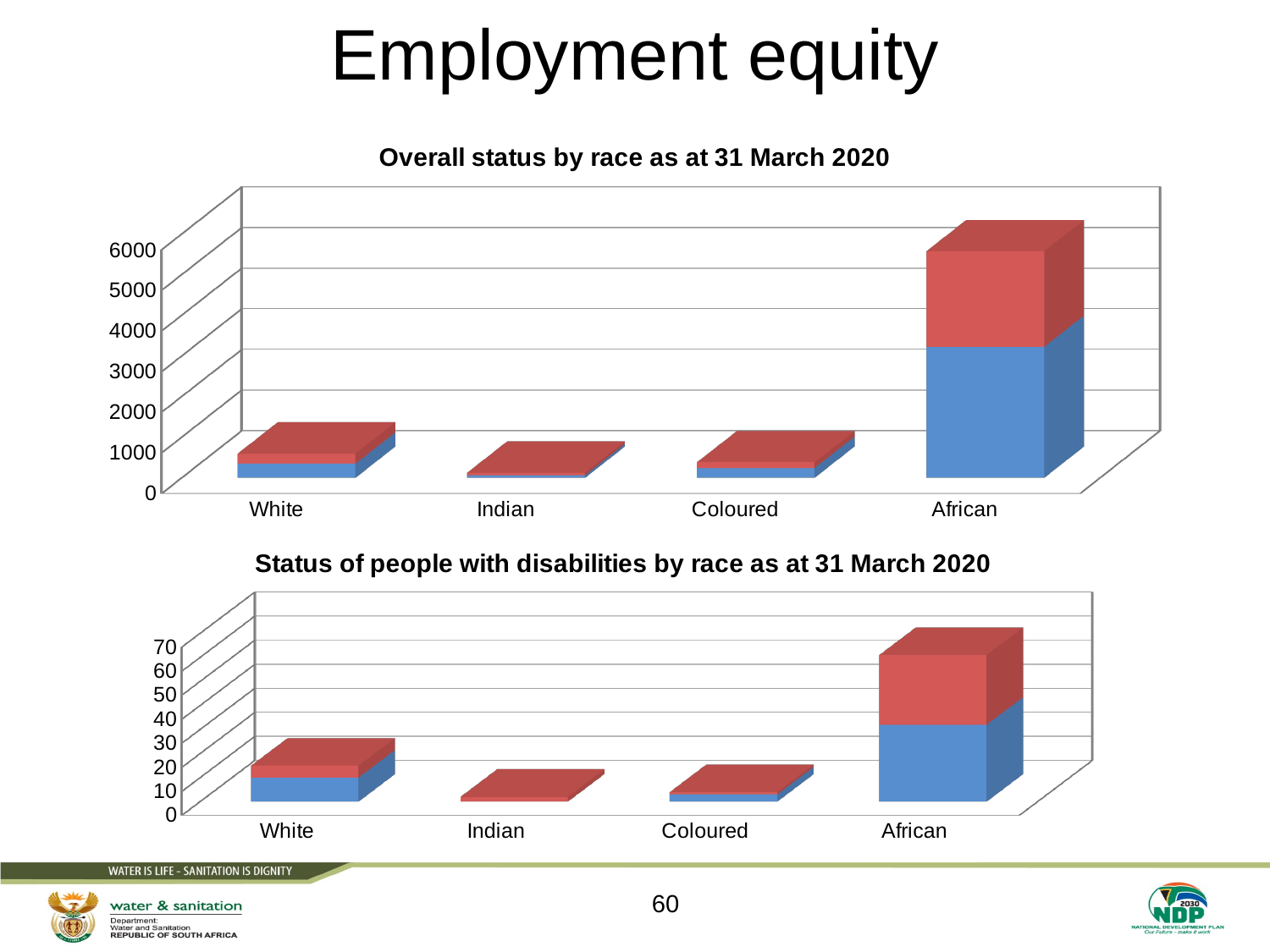
In the 'Status of people with disabilities by race as at 31 March 2020' chart, which race has the lowest bar? Indian In the 'Status of people with disabilities by race as at 31 March 2020' chart, is the total value for African greater or less than 40? greater In the 'Overall status by race as at 31 March 2020' chart, which race has the highest bar? African In the 'Overall status by race as at 31 March 2020' chart, is the total value for Indian greater or less than 1000? less What kind of chart is the 'Status of people with disabilities by race as at 31 March 2020' chart? Bar chart In the 'Overall status by race as at 31 March 2020' chart, which is larger, the bar for African or the bar for White? African In the 'Status of people with disabilities by race as at 31 March 2020' chart, which is larger, the bar for White or the bar for Coloured? White In the 'Overall status by race as at 31 March 2020' chart, which race has the lowest bar? Indian In the 'Status of people with disabilities by race as at 31 March 2020' chart, which race has the highest bar? African How many race categories are shown on the x axis of the 'Overall status by race as at 31 March 2020' chart? 4 In the 'Overall status by race as at 31 March 2020' chart, is the total value for African greater or less than 4000? greater